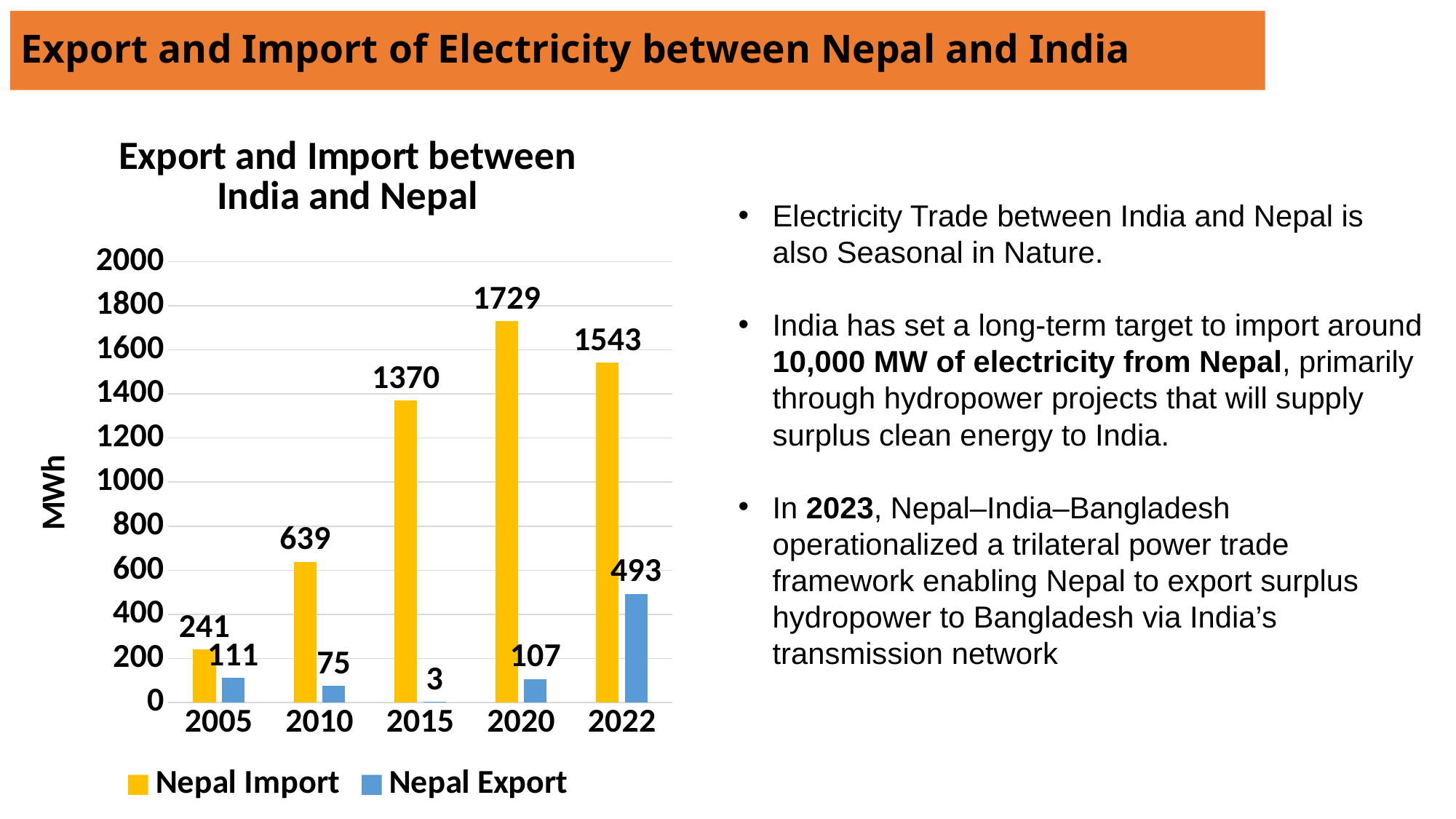
Which year has the highest Nepal Import value? 2020 What is the Nepal Export value for 2015? 3 What is the Nepal Export value for 2022? 493 What kind of chart is shown on the slide? Bar chart Which is larger: Nepal Export in 2005 or Nepal Export in 2010? Nepal Export in 2005 How many years are shown on the x axis? 5 What is the Nepal Import value for 2020? 1729 Does the Nepal Import series rise or fall from 2005 to 2020? Rise How many series does the legend list? 2 What is the difference between Nepal Import in 2020 and Nepal Import in 2022? 186 What unit is shown on the y axis label of the chart? MWh Which year has the lowest Nepal Export value? 2015